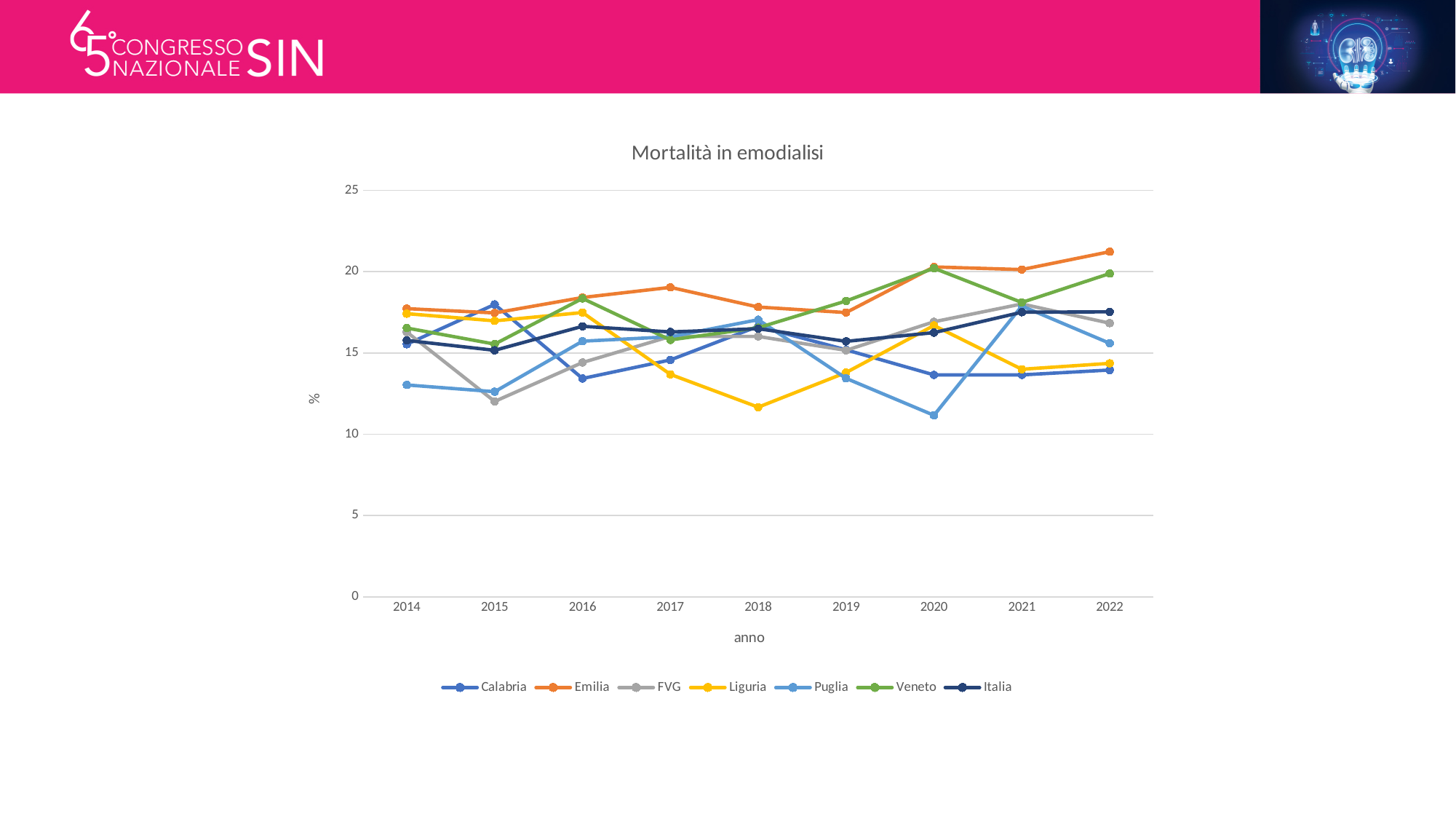
Is the value for Puglia in 2020 greater or less than 15? less Which series has the lowest value in 2020? Puglia What kind of chart is shown on the slide? line chart Which is larger in 2020, the value for Italia or the value for Puglia? Italia What is the title of the chart? Mortalità in emodialisi Which series has the lowest value in 2018? Liguria How many years are shown on the x axis? 9 Does the value for Emilia rise or fall from 2019 to 2022? rise Is the value for Emilia in 2022 greater or less than 20? greater Which series has the highest value in 2022? Emilia How many series does the legend list? 7 What is the label of the x axis? anno